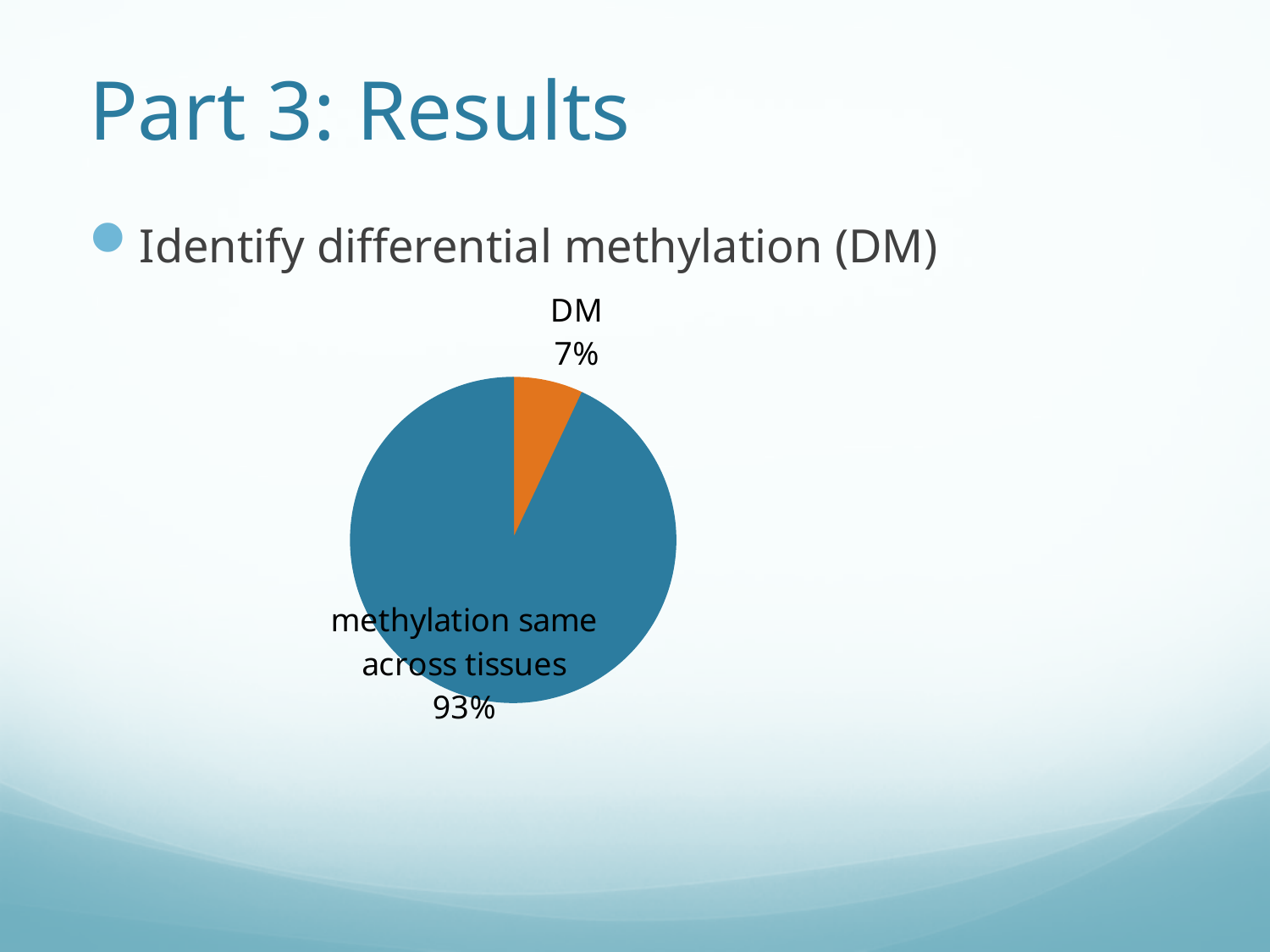
What share of the pie is labelled 'methylation same across tissues'? 93% What colour is the DM slice of the pie? orange How many slices does the pie chart have? 2 Which slice of the pie is the largest? methylation same across tissues What share of the pie is labelled DM? 7% What kind of chart is shown on the slide? pie chart What is the difference in percentage points between the 'methylation same across tissues' slice and the DM slice? 86 Which slice of the pie is the smallest? DM Which is larger, the DM slice or the 'methylation same across tissues' slice? methylation same across tissues What colour is the 'methylation same across tissues' slice of the pie? blue